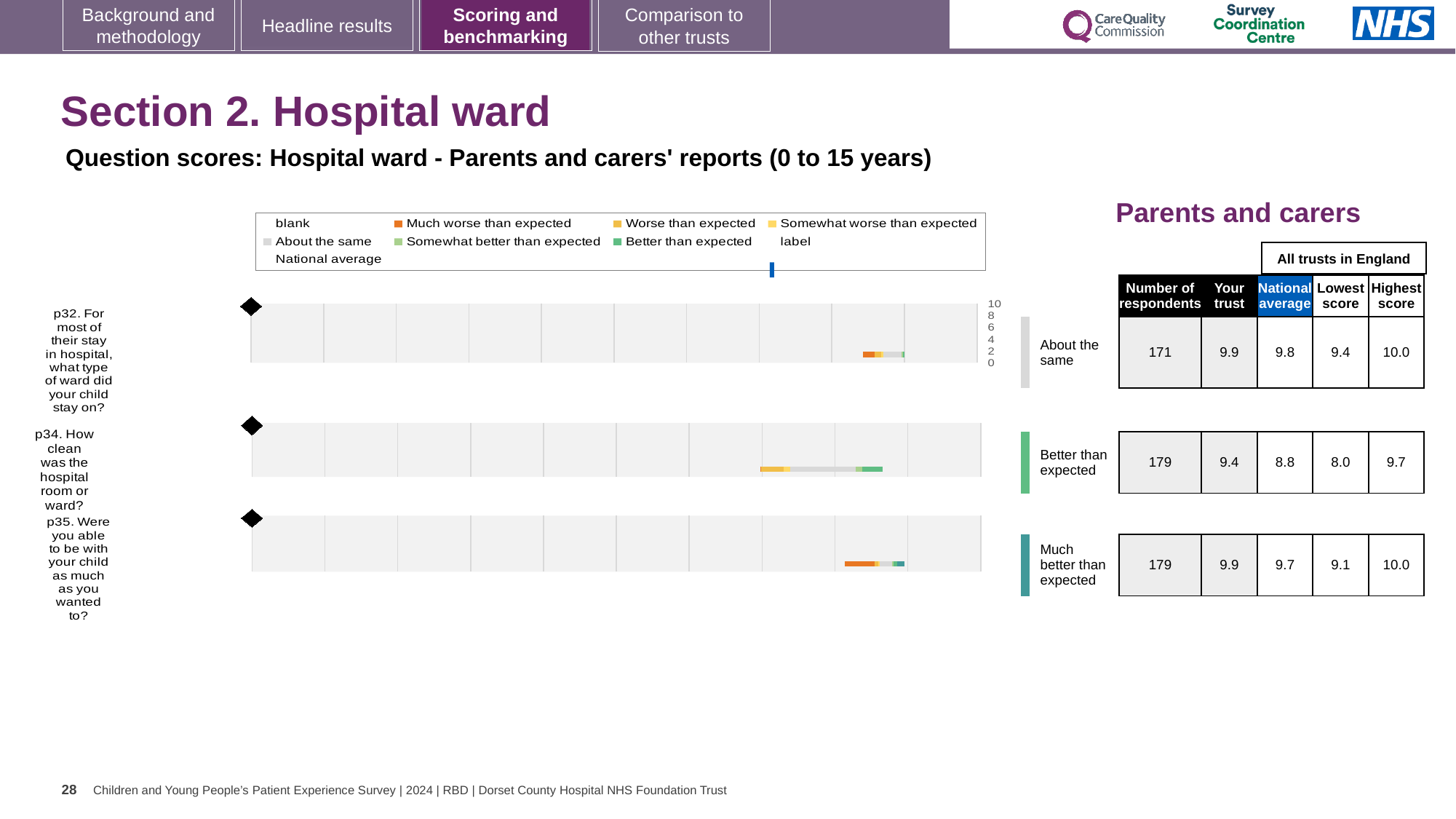
What is the 'Your trust' score for p34 (How clean was the hospital room or ward?)? 9.4 What is the difference between the 'Your trust' score and the national average for p34? 0.6 How many respondents answered p35 (Were you able to be with your child as much as you wanted to?)? 179 What is the national average score for p32 (For most of their stay in hospital, what type of ward did your child stay on?)? 9.8 What is the highest score among all trusts in England for p34? 9.7 Which has the higher 'Your trust' score, p32 or p34? p32 Which question has the lowest 'Your trust' score? p34 Which benchmark category is p35 rated as? Much better than expected What kind of chart is used to show the question scores? Bar chart What is the lowest score among all trusts in England for p35? 9.1 Which question has the lowest national average score? p34 How many survey questions are plotted on the slide? 3